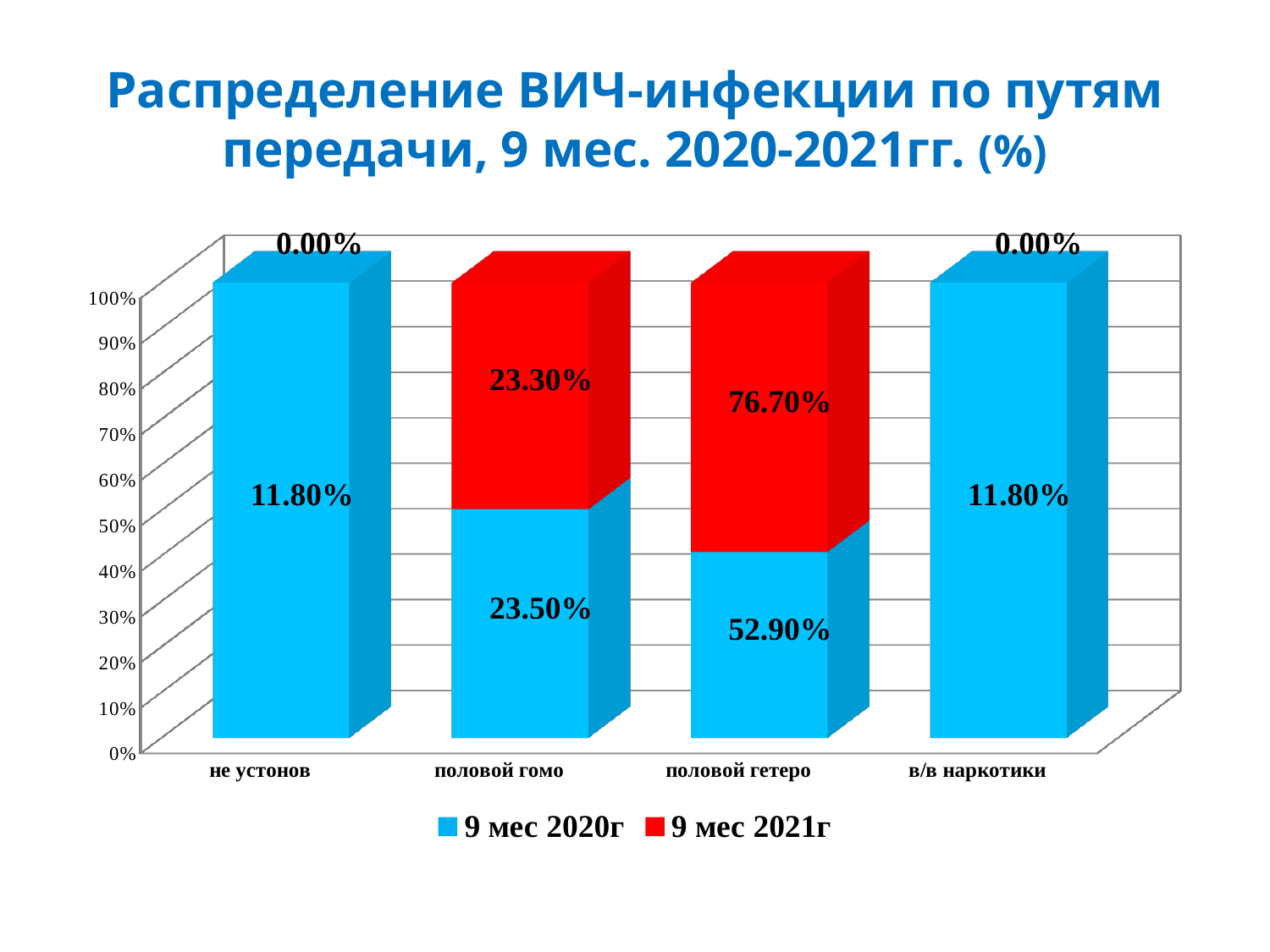
For половой гетеро, which series has the larger value: 9 мес 2020г or 9 мес 2021г? 9 мес 2021г What kind of chart is shown on the slide? Stacked bar chart How many categories are shown on the x axis? 4 What is the value for в/в наркотики in the 9 мес 2021г series? 0.00% What is the value for не устонов in the 9 мес 2020г series? 11.80% What is the difference between the 9 мес 2020г values for половой гетеро and половой гомо? 29.40% What is the value for половой гетеро in the 9 мес 2021г series? 76.70% How many series does the legend list? 2 What is the value for половой гомо in the 9 мес 2020г series? 23.50% Which category has the highest value in the 9 мес 2021г series? половой гетеро Which category has the highest value in the 9 мес 2020г series? половой гетеро What is the difference between the 9 мес 2021г and 9 мес 2020г values for половой гетеро? 23.80%